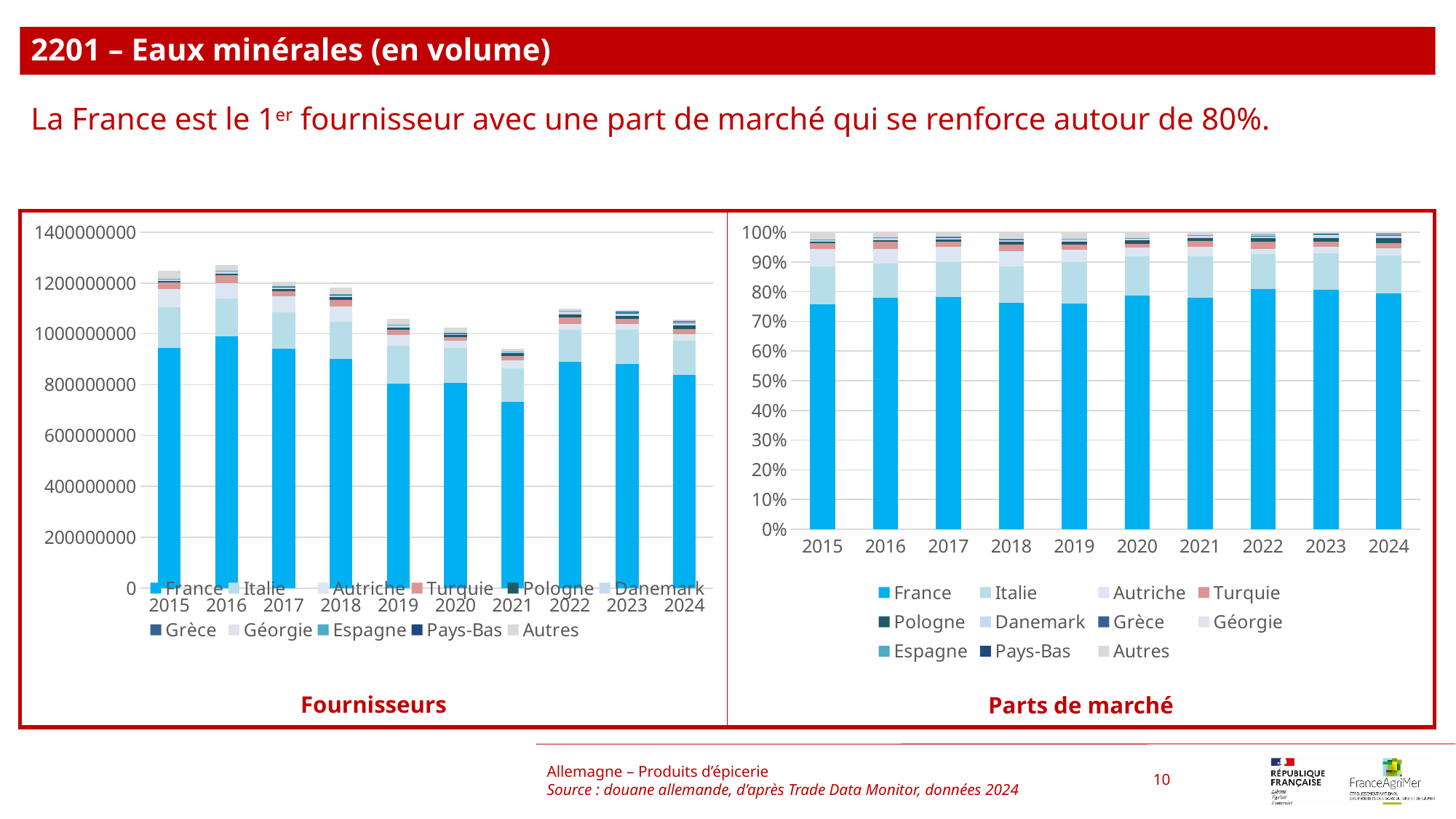
In the 'Fournisseurs' chart, is the total bar for 2021 greater or less than 1000000000? less In the 'Fournisseurs' chart, which year has the highest total bar? 2016 In the 'Parts de marché' chart, is the France share for 2015 greater or less than 70%? greater What is the title of the chart on the right of the slide? Parts de marché In the 'Fournisseurs' chart, is the France value for 2021 greater or less than 800000000? less In the 'Fournisseurs' chart, is the total bar for 2016 larger or smaller than the total bar for 2021? larger What type of chart is the 'Fournisseurs' chart on the left? stacked bar chart In the 'Parts de marché' chart, which series occupies the largest share of each bar? France How many series does the legend of the 'Fournisseurs' chart list? 11 In the 'Fournisseurs' chart, which year has the lowest total bar? 2021 How many years are shown on the x axis of the 'Parts de marché' chart? 10